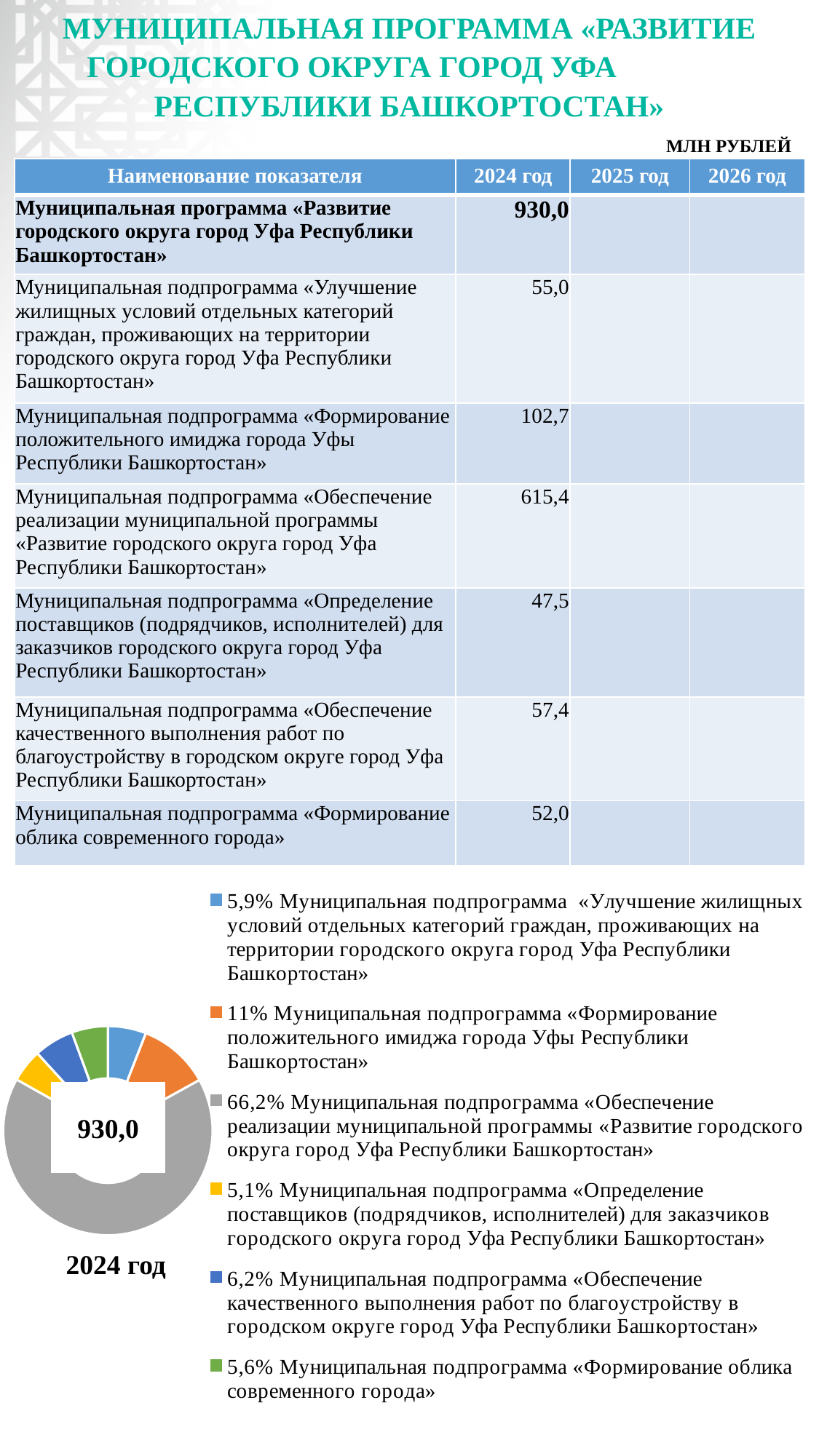
Which subprogram has the largest slice in the doughnut chart? Муниципальная подпрограмма «Обеспечение реализации муниципальной программы «Развитие городского округа город Уфа Республики Башкортостан» What share of the doughnut chart does the subprogram «Формирование положительного имиджа города Уфы Республики Башкортостан» have? 11% What kind of chart is shown at the bottom of the slide? Doughnut (pie) chart What share of the doughnut chart does the subprogram «Обеспечение реализации муниципальной программы «Развитие городского округа город Уфа Республики Башкортостан» have? 66,2% What share of the doughnut chart does the subprogram «Формирование облика современного города» have? 5,6% Which year is the doughnut chart labelled with? 2024 год What total value is printed in the centre of the doughnut chart? 930,0 Which subprogram has the smallest slice in the doughnut chart? Муниципальная подпрограмма «Определение поставщиков (подрядчиков, исполнителей) для заказчиков городского округа город Уфа Республики Башкортостан» What is the difference in share between the «Обеспечение реализации муниципальной программы...» slice (66,2%) and the «Формирование положительного имиджа...» slice (11%)? 55,2% How many slices does the doughnut chart have? 6 In the doughnut chart, which has the larger share: «Улучшение жилищных условий отдельных категорий граждан...» or «Формирование положительного имиджа города Уфы...»? «Формирование положительного имиджа города Уфы Республики Башкортостан»